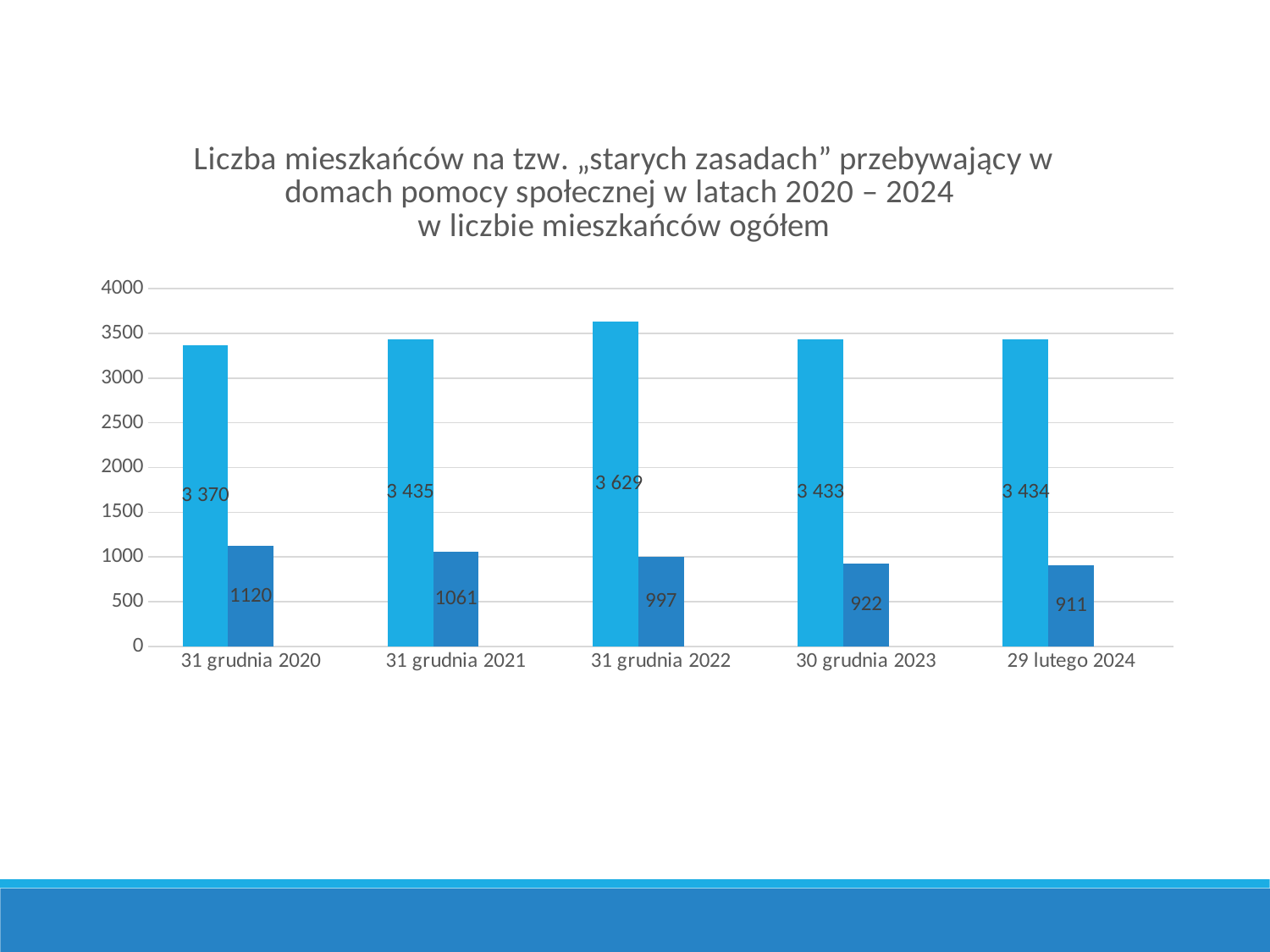
What is the difference between the dark blue bar values for 31 grudnia 2020 and 31 grudnia 2021? 59 Is the dark blue bar for 31 grudnia 2021 greater or less than 1000? greater Which is larger: the dark blue bar for 31 grudnia 2022 or the dark blue bar for 30 grudnia 2023? 31 grudnia 2022 What is the value of the dark blue bar for 31 grudnia 2020? 1120 Which date has the lowest dark blue bar? 29 lutego 2024 How many dates are shown on the x axis? 5 What is the value of the light blue bar for 31 grudnia 2022? 3 629 Which date has the highest light blue bar? 31 grudnia 2022 Do the dark blue bar values rise or fall from 31 grudnia 2020 to 29 lutego 2024? fall What kind of chart is shown on the slide? bar chart What is the value of the light blue bar for 30 grudnia 2023? 3 433 What is the value of the dark blue bar for 29 lutego 2024? 911